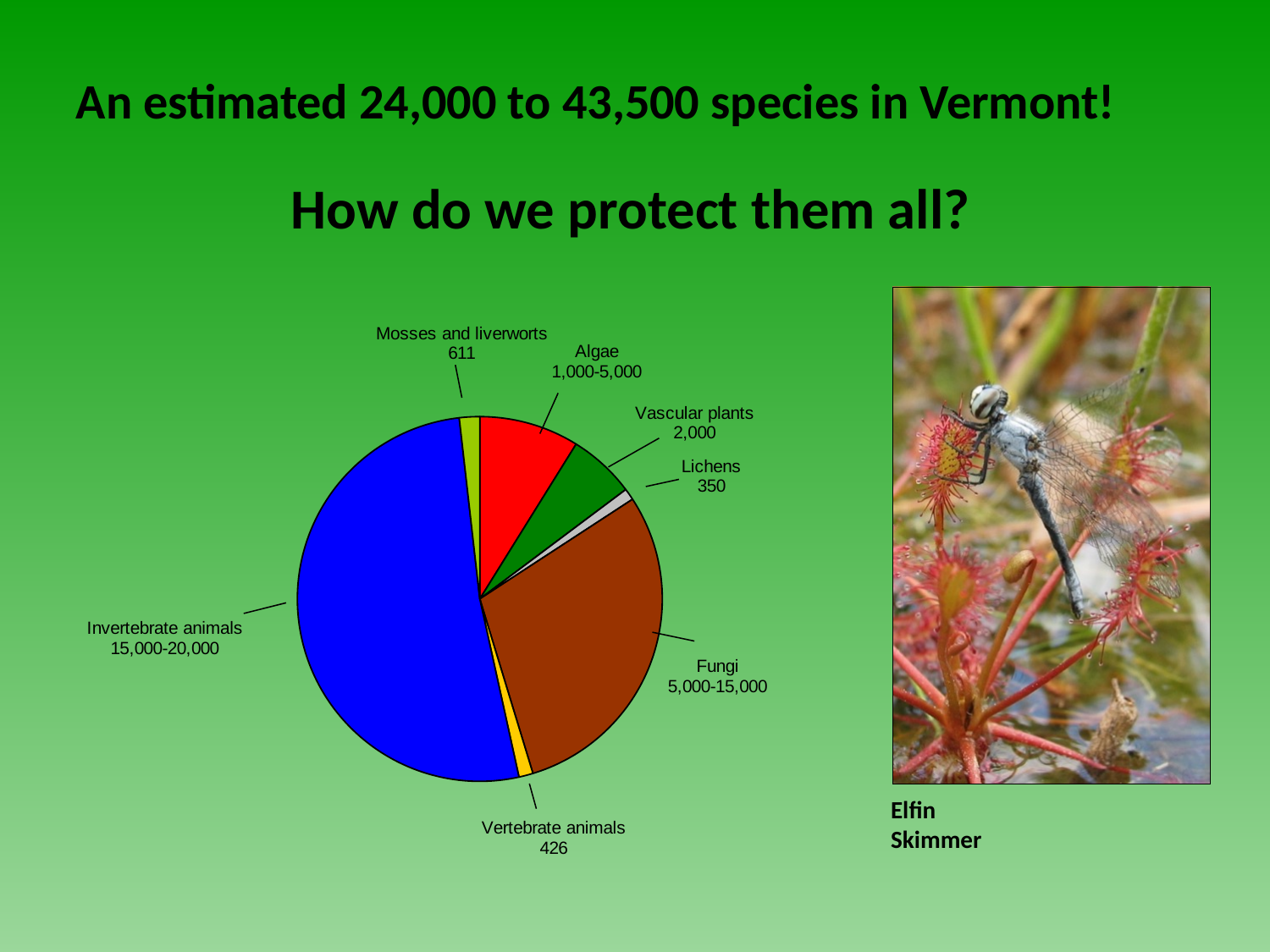
What range is shown for Fungi in the pie chart? 5,000-15,000 What type of chart is shown on the slide? Pie chart What is the difference between the values for Mosses and liverworts and Vertebrate animals? 185 What value is shown for Vertebrate animals in the pie chart? 426 What range is shown for Invertebrate animals in the pie chart? 15,000-20,000 Which category has the smallest slice of the pie chart? Lichens What is the difference between the values for Vascular plants and Lichens? 1,650 How many categories are shown in the pie chart? 7 Which category has the largest slice of the pie chart? Invertebrate animals What value is shown for Lichens in the pie chart? 350 What value is shown for Mosses and liverworts in the pie chart? 611 Which is larger, the slice for Fungi or the slice for Vascular plants? Fungi